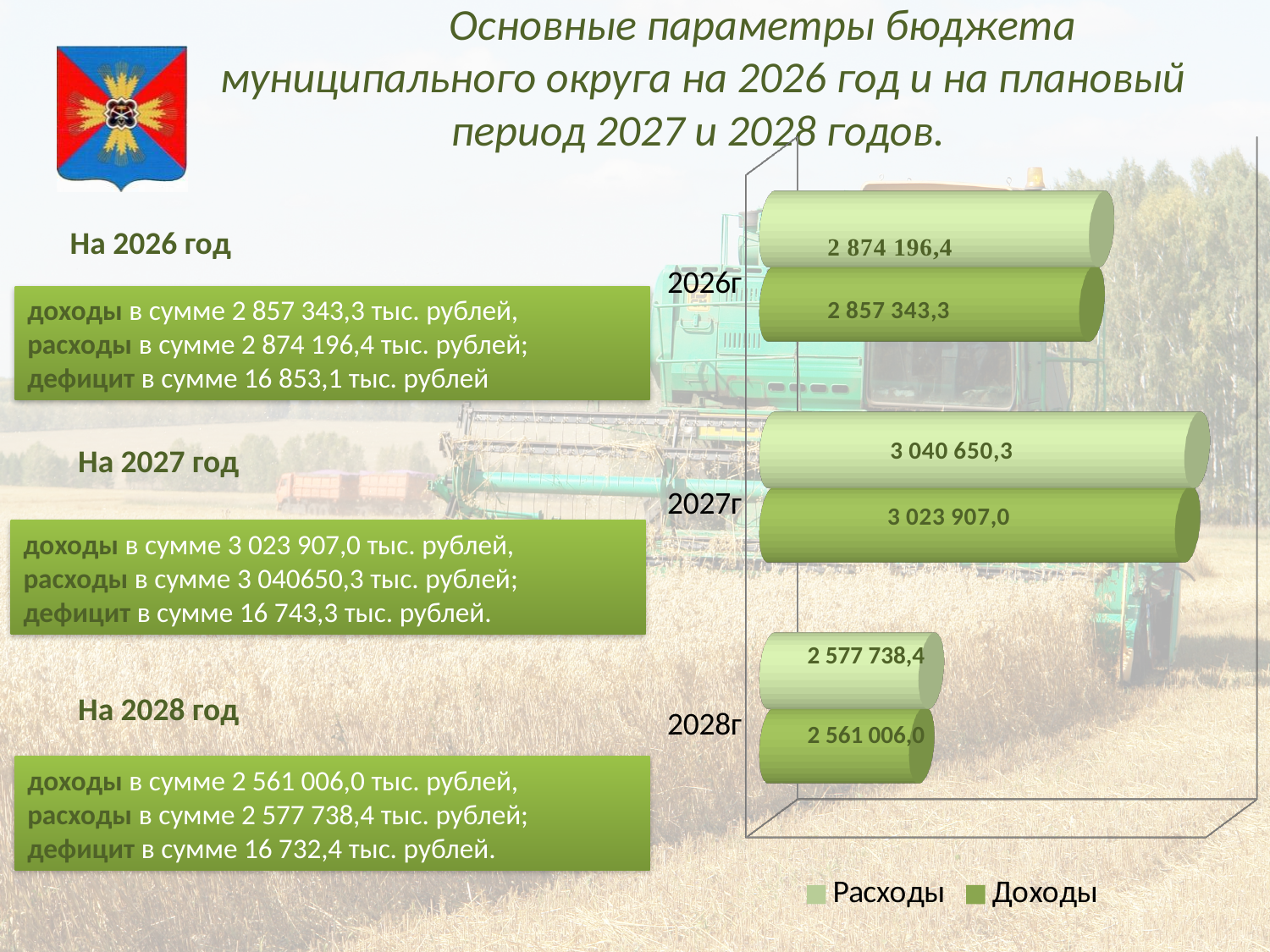
What is the value of Доходы for 2027г? 3 023 907,0 What is the difference between Расходы and Доходы for 2027г? 16 743,3 Which year has the lowest value of Доходы? 2028г What kind of chart is shown on the slide? Bar chart What is the value of Расходы for 2026г? 2 874 196,4 How many years (categories) are shown in the chart? 3 What is the value of Расходы for 2028г? 2 577 738,4 What is the value of Доходы for 2028г? 2 561 006,0 Which is larger for 2028г, Расходы or Доходы? Расходы Which year has the highest value of Расходы? 2027г What is the difference between Расходы and Доходы for 2026г? 16 853,1 How many series does the legend list? 2